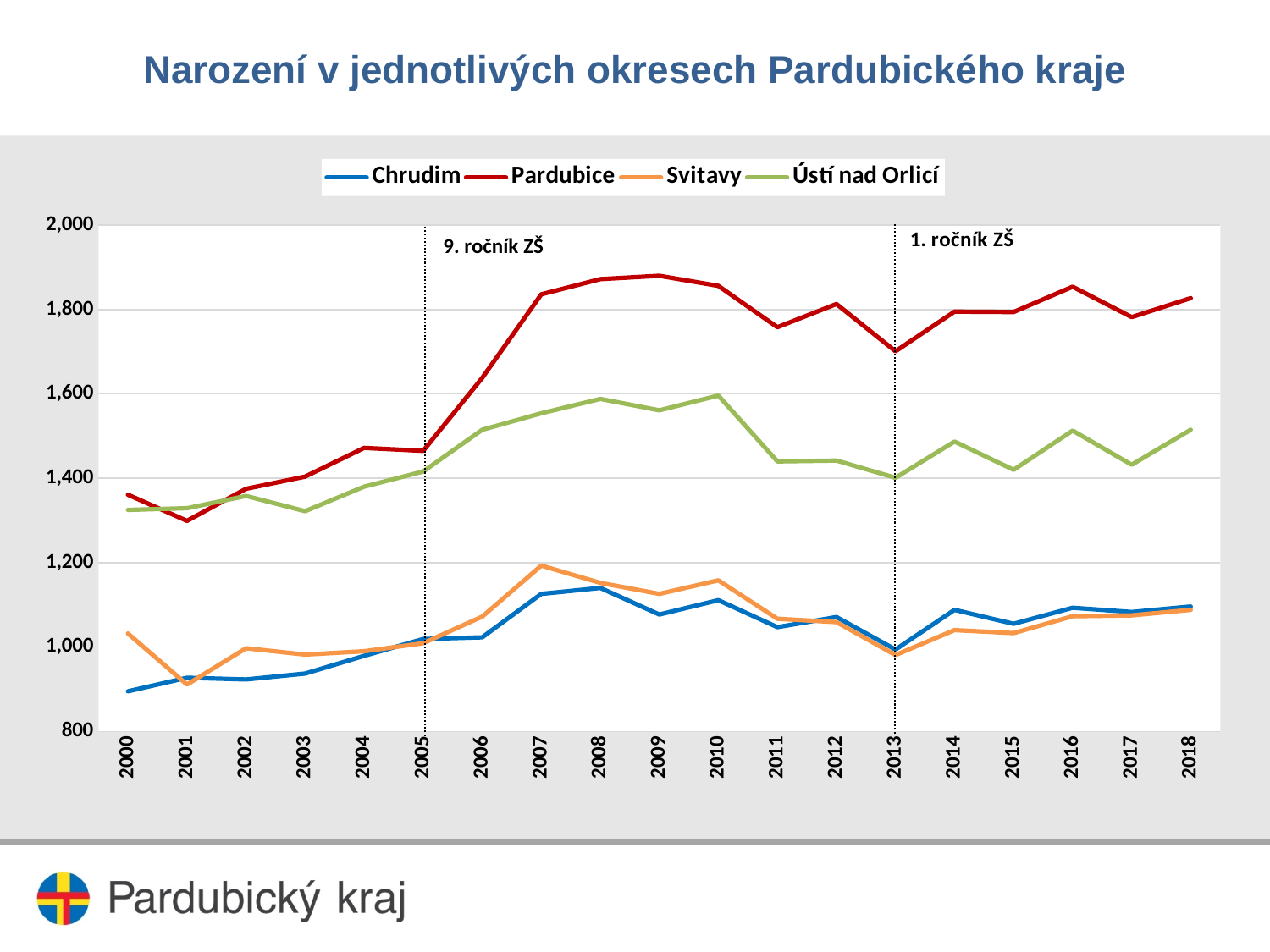
Which series has the lowest value in 2000? Chrudim Is the value for Chrudim in 2000 greater or less than 1,000? less What is the title of the chart? Narození v jednotlivých okresech Pardubického kraje How many series does the legend list? 4 How many years are plotted along the x axis? 19 Which series has the highest value in 2018? Pardubice What kind of chart is shown on the slide? line chart Does the Pardubice line rise or fall between 2005 and 2009? rise Is the value for Svitavy in 2007 greater or less than 1,000? greater Is the value for Pardubice in 2001 greater or less than 1,400? less Which is larger for Ústí nad Orlicí: the value in 2008 or the value in 2013? 2008